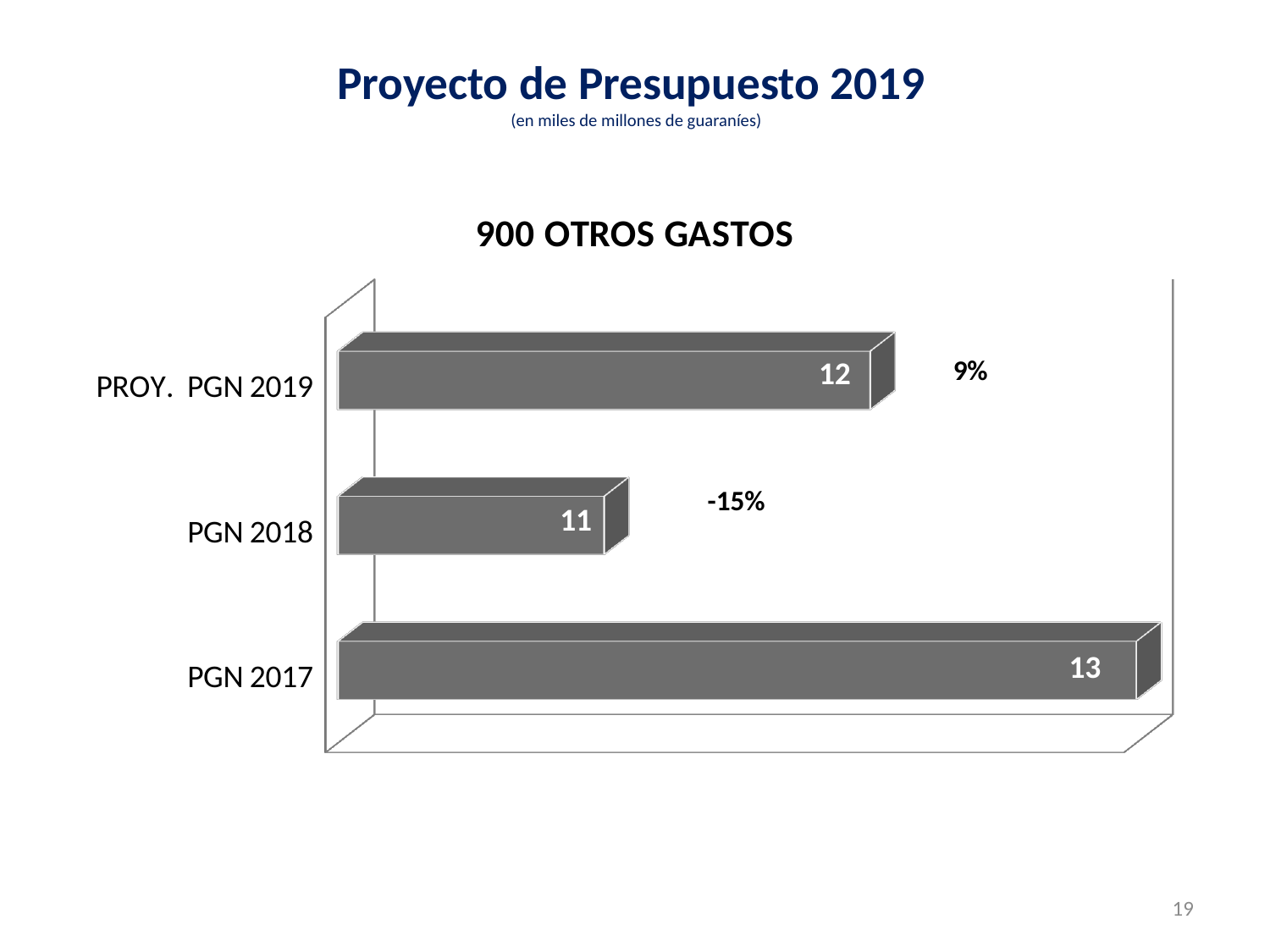
Which category has the lowest value? PGN 2018 Which is larger, the value for PGN 2017 or the value for PROY. PGN 2019? PGN 2017 How many categories are shown in the chart? 3 What percentage change is shown next to the PGN 2018 bar? -15% What is the value for PROY. PGN 2019? 12 What is the difference between the values for PROY. PGN 2019 and PGN 2018? 1 What is the title of the chart? 900 OTROS GASTOS Which category has the highest value? PGN 2017 What is the difference between the values for PGN 2017 and PGN 2018? 2 What is the value for PGN 2017? 13 What kind of chart is shown on the slide? bar chart What is the value for PGN 2018? 11